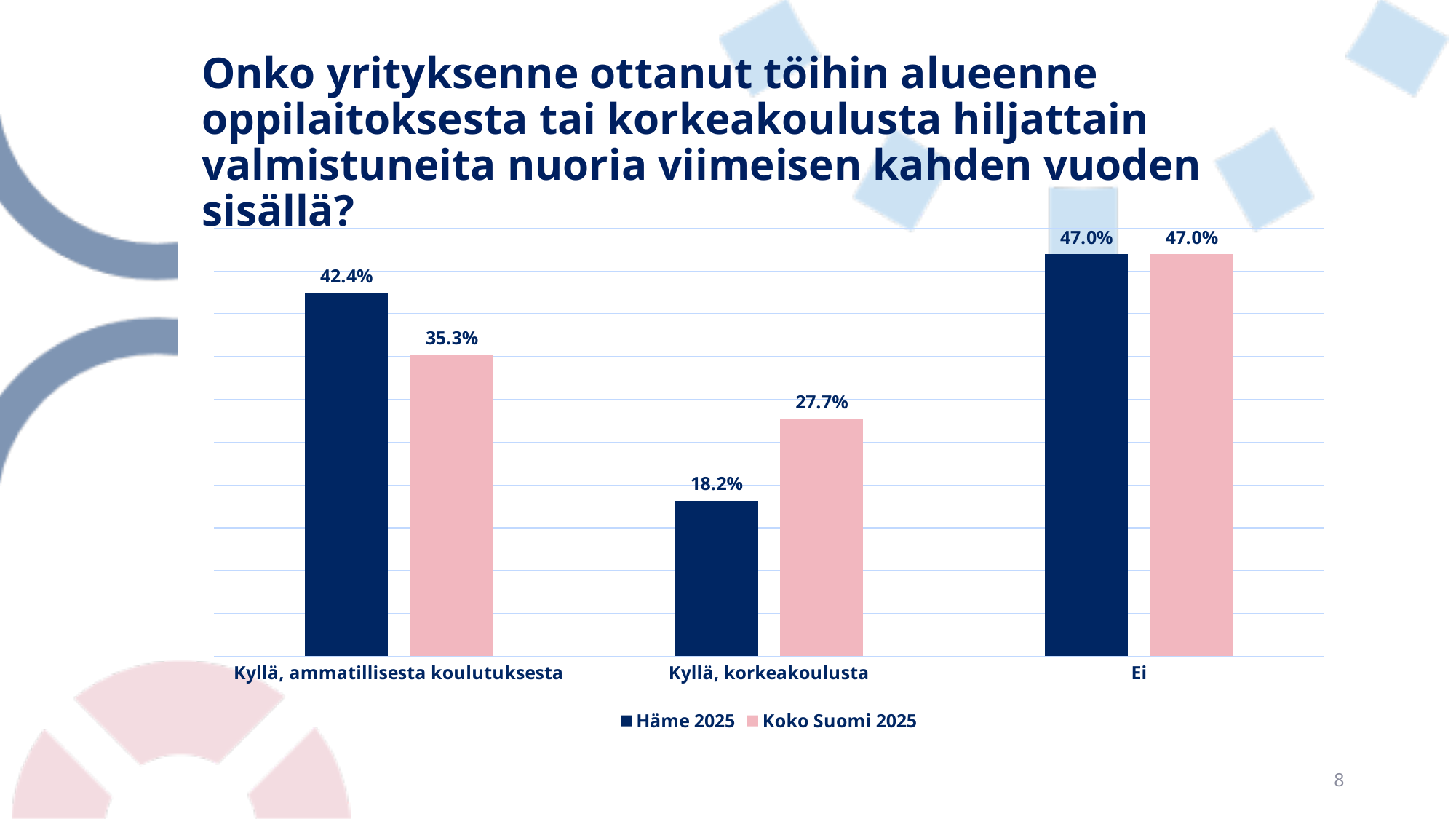
What is the value for Häme 2025 in the category "Kyllä, ammatillisesta koulutuksesta"? 42.4% Which category has the lowest value for Häme 2025? Kyllä, korkeakoulusta Which category has the highest value for Koko Suomi 2025? Ei What is the difference between the Koko Suomi 2025 and Häme 2025 values in the category "Kyllä, korkeakoulusta"? 9.5 percentage points What is the difference between the Häme 2025 and Koko Suomi 2025 values in the category "Kyllä, ammatillisesta koulutuksesta"? 7.1 percentage points In the category "Kyllä, korkeakoulusta", which series has the larger value, Häme 2025 or Koko Suomi 2025? Koko Suomi 2025 What is the value for Koko Suomi 2025 in the category "Kyllä, korkeakoulusta"? 27.7% How many categories are shown on the x axis of the chart? 3 What is the value for Häme 2025 in the category "Ei"? 47.0% What is the value for Koko Suomi 2025 in the category "Kyllä, ammatillisesta koulutuksesta"? 35.3% What kind of chart is shown on the slide? Bar chart How many series does the legend list? 2